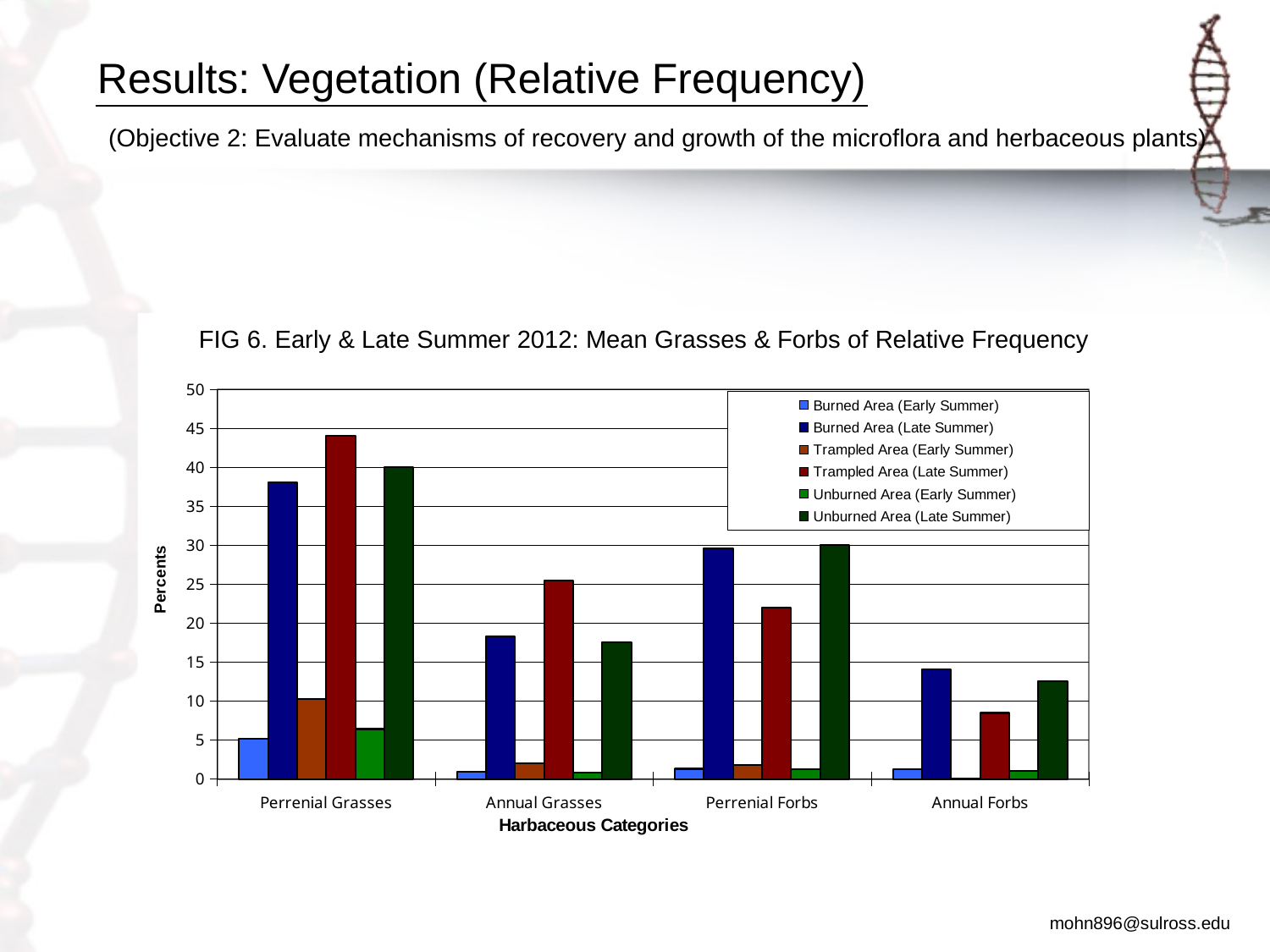
In FIG 6, for Annual Grasses, which is larger: Trampled Area (Late Summer) or Burned Area (Late Summer)? Trampled Area (Late Summer) In FIG 6, is the Trampled Area (Late Summer) value for Perrenial Grasses greater or less than 40? greater In FIG 6, for Perrenial Grasses, which is larger: Trampled Area (Early Summer) or Burned Area (Early Summer)? Trampled Area (Early Summer) What is the y-axis title of the chart in FIG 6? Percents In FIG 6, is the Unburned Area (Late Summer) value for Perrenial Forbs greater or less than 25? greater How many herbaceous categories are shown on the x axis of FIG 6? 4 In FIG 6, is the Burned Area (Late Summer) value for Annual Grasses greater or less than 20? less In FIG 6, which herbaceous category has the lowest value for Unburned Area (Late Summer)? Annual Forbs What is the x-axis title of the chart in FIG 6? Harbaceous Categories What kind of chart is shown in FIG 6? Bar chart How many series does the legend of FIG 6 list? 6 In FIG 6, which herbaceous category has the highest value for Trampled Area (Late Summer)? Perrenial Grasses